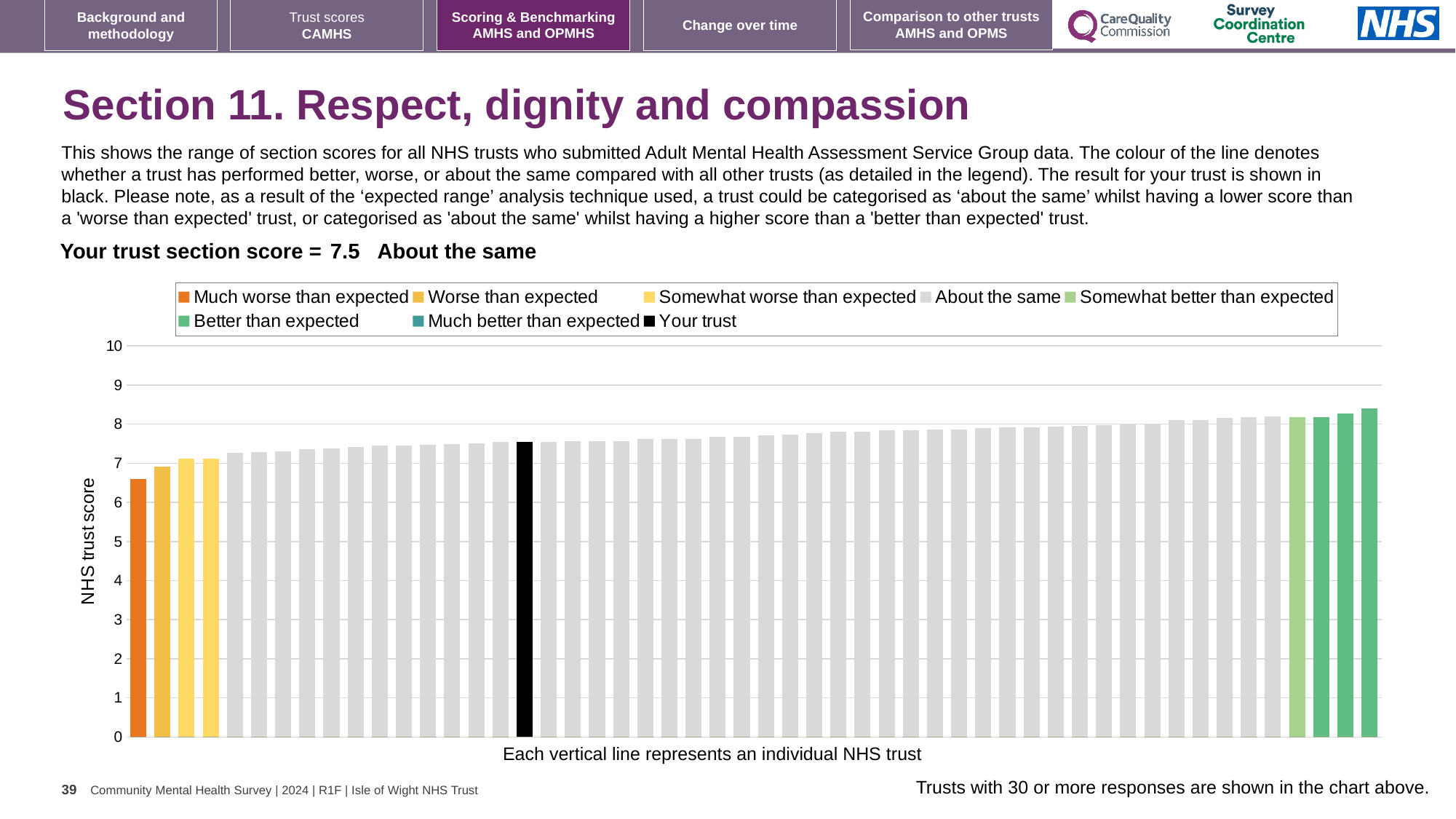
What is the label on the vertical axis of the chart? NHS trust score Is the value of the black 'Your trust' bar greater or less than 7? greater Which legend category does the tallest bar in the chart belong to? Better than expected Which is higher: the black 'Your trust' bar or the orange 'Much worse than expected' bar? Your trust What kind of chart is shown on the slide? bar chart How many entries does the chart legend list? 8 Is the value of the orange 'Much worse than expected' bar greater or less than 7? less How many bars are coloured orange ('Much worse than expected') in the chart? 1 Is the value of the black 'Your trust' bar greater or less than 8? less Do the bar values rise or fall from left to right along the x axis? rise What is the section score for your trust shown on the slide? 7.5